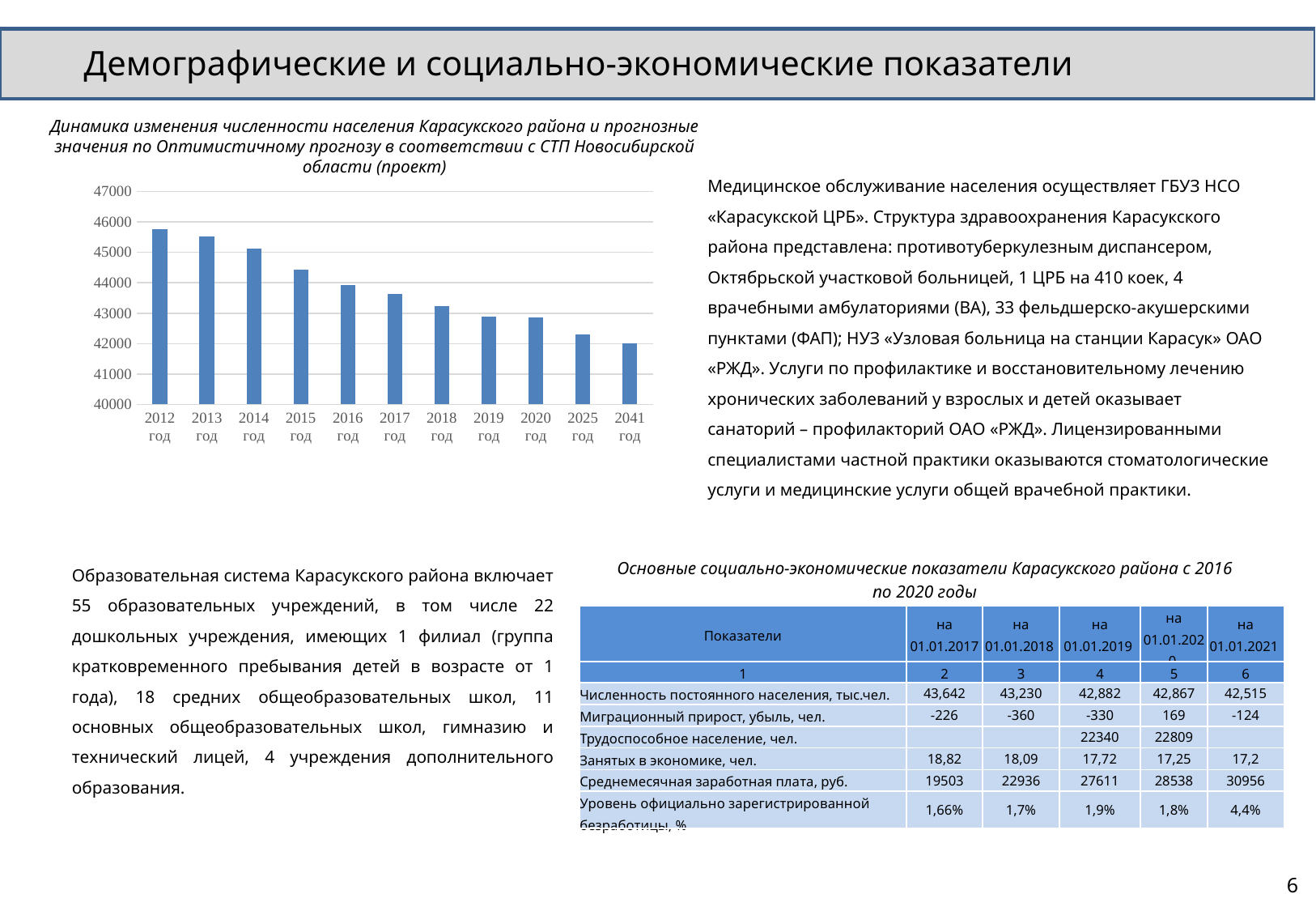
Which year has the highest bar in the chart? 2012 год Which year has the lowest bar in the chart? 2041 год Do the values in the chart rise or fall from 2012 год to 2041 год? fall Is the value for 2012 год greater or less than 45000? greater What is the lowest value shown on the chart's vertical axis? 40000 Is the value for 2025 год greater or less than 43000? less What kind of chart is shown on the slide? bar chart Which is larger, the value for 2013 год or the value for 2019 год? 2013 год Is the value for 2018 год greater or less than 43000? greater How many categories (years) are shown on the x axis of the chart? 11